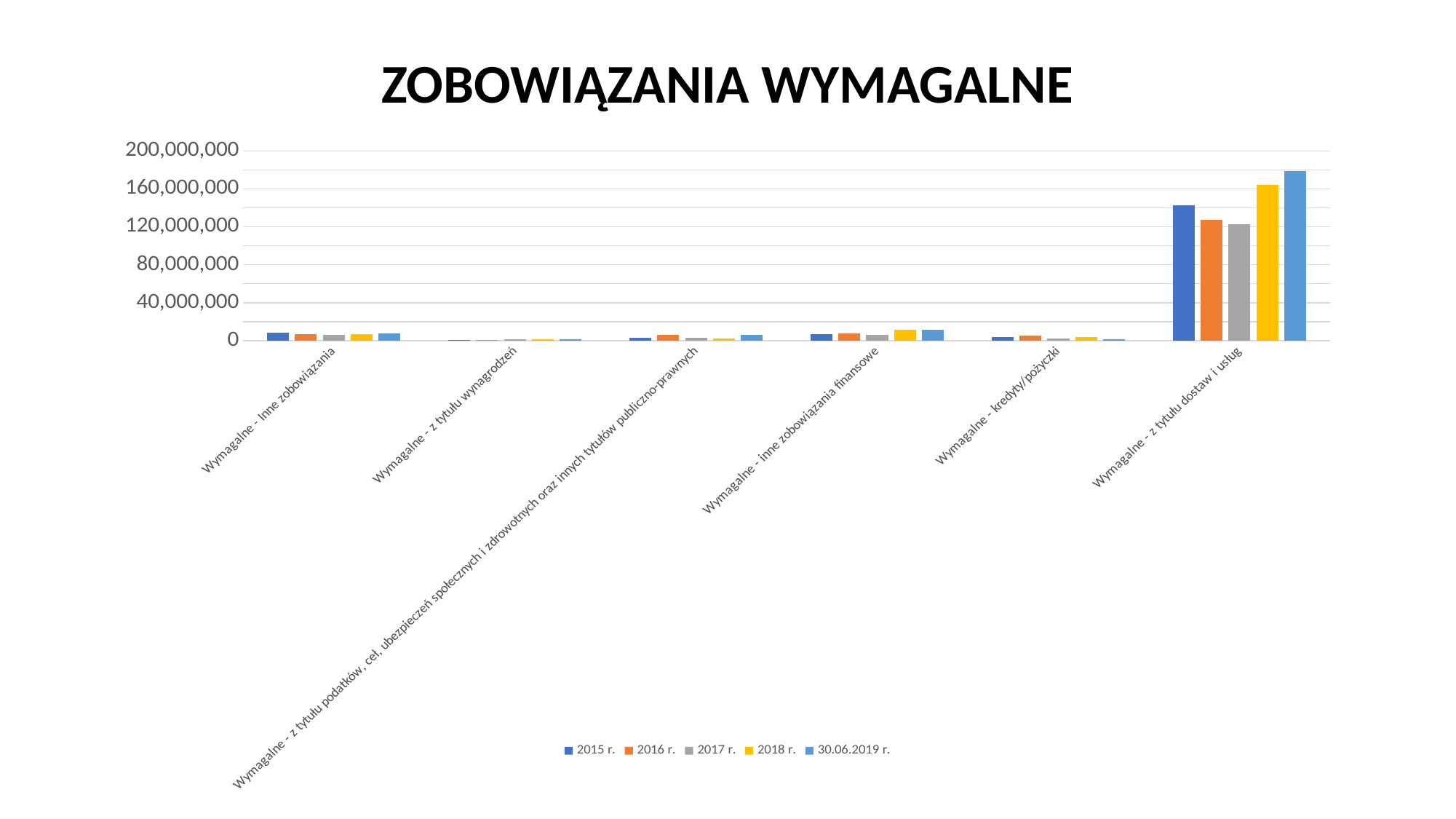
How many series does the legend list? 5 How many categories are shown on the x axis? 6 What kind of chart is shown on the slide? bar chart Which category has the highest values across all series? Wymagalne - z tytułu dostaw i usług In the category 'Wymagalne - z tytułu dostaw i usług', which series has the lowest value? 2017 r. What is the title of the chart? ZOBOWIĄZANIA WYMAGALNE Is the value for 2015 r. in the category 'Wymagalne - z tytułu dostaw i usług' greater or less than 120,000,000? greater Which series is shown in yellow in the legend? 2018 r. Is the value for 2017 r. in the category 'Wymagalne - z tytułu dostaw i usług' greater or less than 160,000,000? less In the category 'Wymagalne - z tytułu dostaw i usług', which is larger: the value for 2018 r. or the value for 2017 r.? 2018 r. Is the value for 2018 r. in the category 'Wymagalne - z tytułu dostaw i usług' greater or less than 200,000,000? less